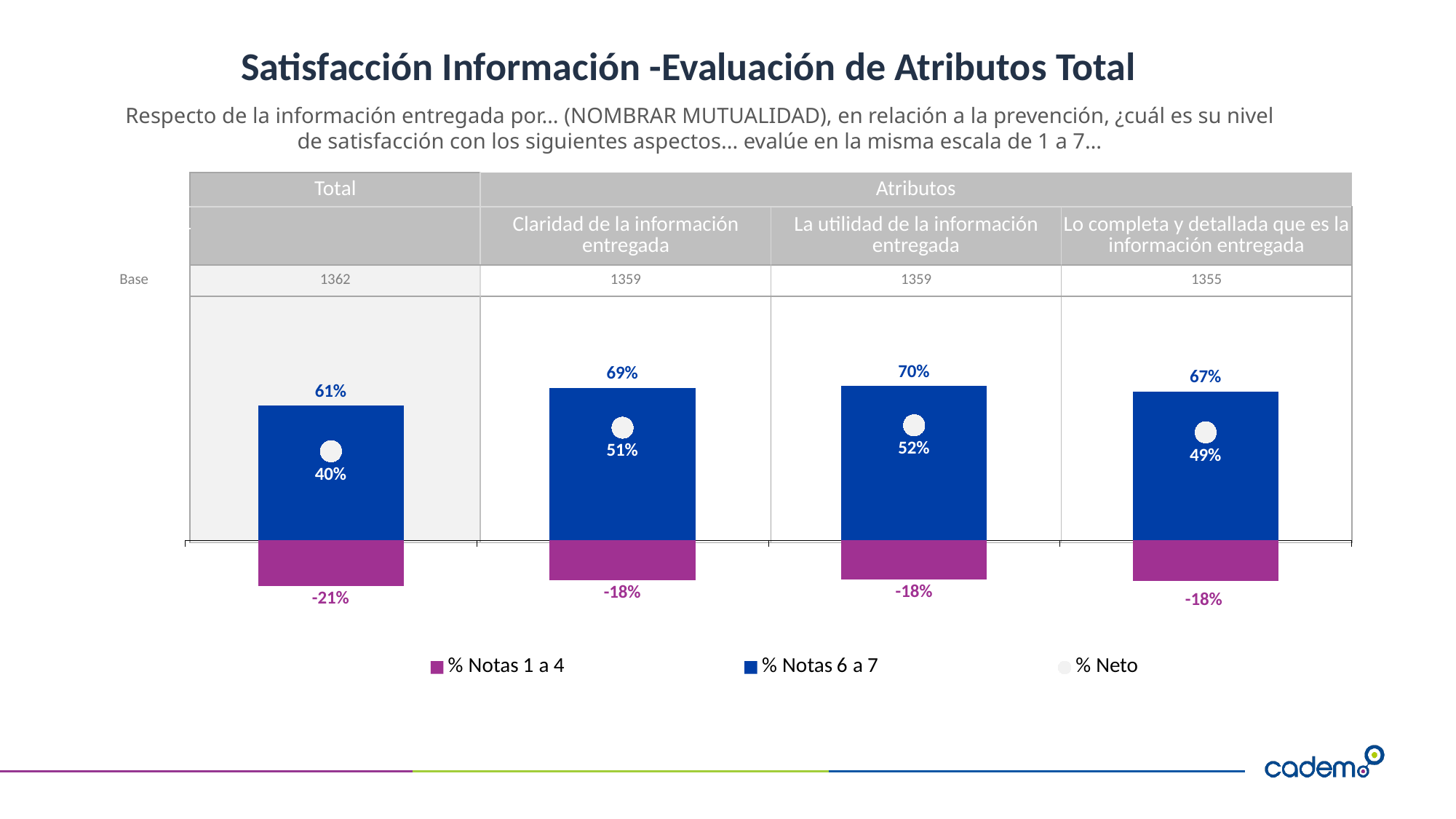
Which category has the highest % Notas 6 a 7 value? La utilidad de la información entregada How many categories are shown in the chart? 4 What is the % Notas 6 a 7 value for Total? 61% What is the % Notas 6 a 7 value for Lo completa y detallada que es la información entregada? 67% What kind of chart is shown on the slide? Bar chart What is the difference between the % Notas 6 a 7 values for La utilidad de la información entregada and Total? 9% Which is larger, the % Neto value for Claridad de la información entregada or for Lo completa y detallada que es la información entregada? Claridad de la información entregada How many series does the legend list? 3 What is the % Notas 1 a 4 value for Total? -21% Which category has the lowest % Neto value? Total What is the base (number of respondents) shown for Total? 1362 What is the % Neto value for Claridad de la información entregada? 51%